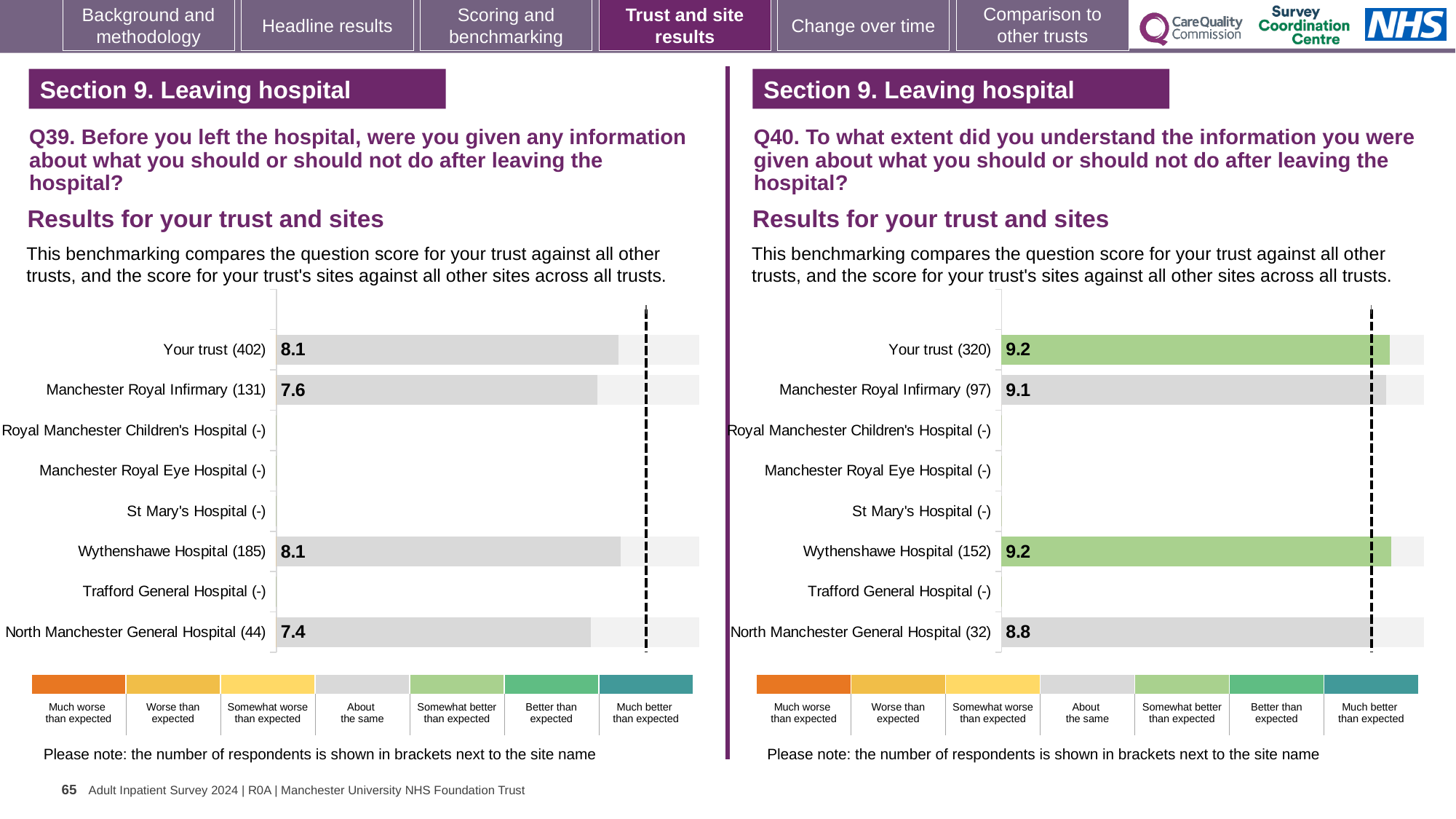
On the Q40 chart (right), what is the score for Your trust? 9.2 What type of chart is used for the Q39 results (left)? Bar chart On the Q39 chart (left), what is the score for North Manchester General Hospital? 7.4 On the Q40 chart (right), which site with a plotted score has the lowest score? North Manchester General Hospital On the Q40 chart (right), what is the difference between the score for Wythenshawe Hospital and the score for North Manchester General Hospital? 0.4 On the Q40 chart (right), how many respondents are shown in brackets for Wythenshawe Hospital? 152 On the Q39 chart (left), what is the score for Manchester Royal Infirmary? 7.6 On the Q39 chart (left), what is the difference between the score for Your trust and the score for Manchester Royal Infirmary? 0.5 On the Q40 chart (right), what is the score for North Manchester General Hospital? 8.8 How many site/trust categories are listed on the Q40 chart (right)? 8 On the Q39 chart (left), which has the higher score, Manchester Royal Infirmary or Wythenshawe Hospital? Wythenshawe Hospital On the Q39 chart (left), which site with a plotted score has the lowest score? North Manchester General Hospital